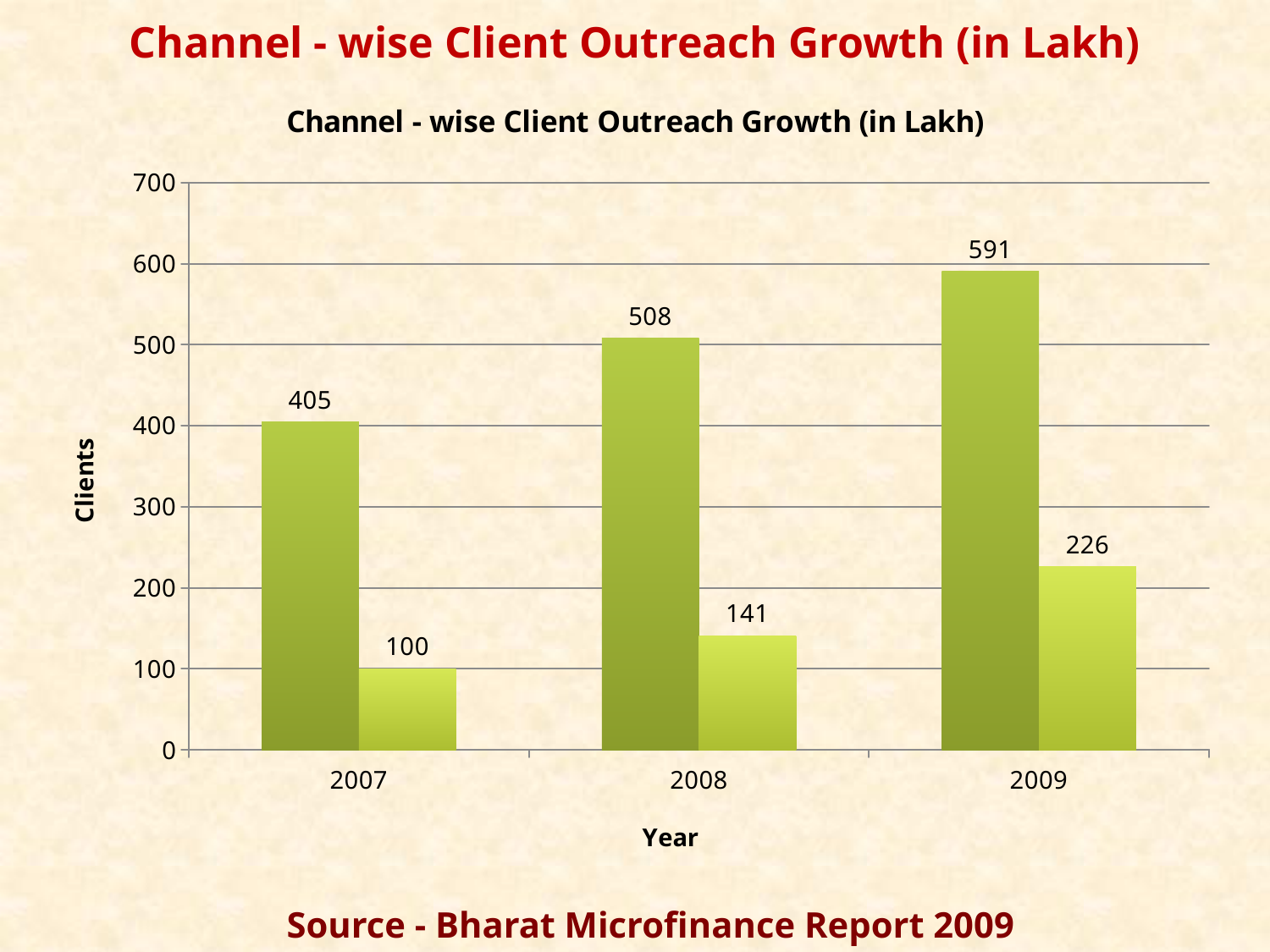
In which year is the lighter green (right) bar lowest? 2007 Do the values of the darker green (left) bars rise or fall from 2007 to 2009? Rise What kind of chart is shown on the slide? Bar chart What is the value of the lighter green (right) bar for 2009? 226 Is the value of the darker green bar for 2008 greater or less than 500? greater Which is larger: the lighter green bar for 2009 or the lighter green bar for 2008? 2009 By how much did the darker green (left) bar increase from 2007 to 2008? 103 How many years are shown on the x axis? 3 What is the value of the darker green (left) bar for 2007? 405 What is the difference between the darker green bar and the lighter green bar in 2009? 365 In which year is the darker green (left) bar highest? 2009 What is the value of the lighter green (right) bar for 2008? 141